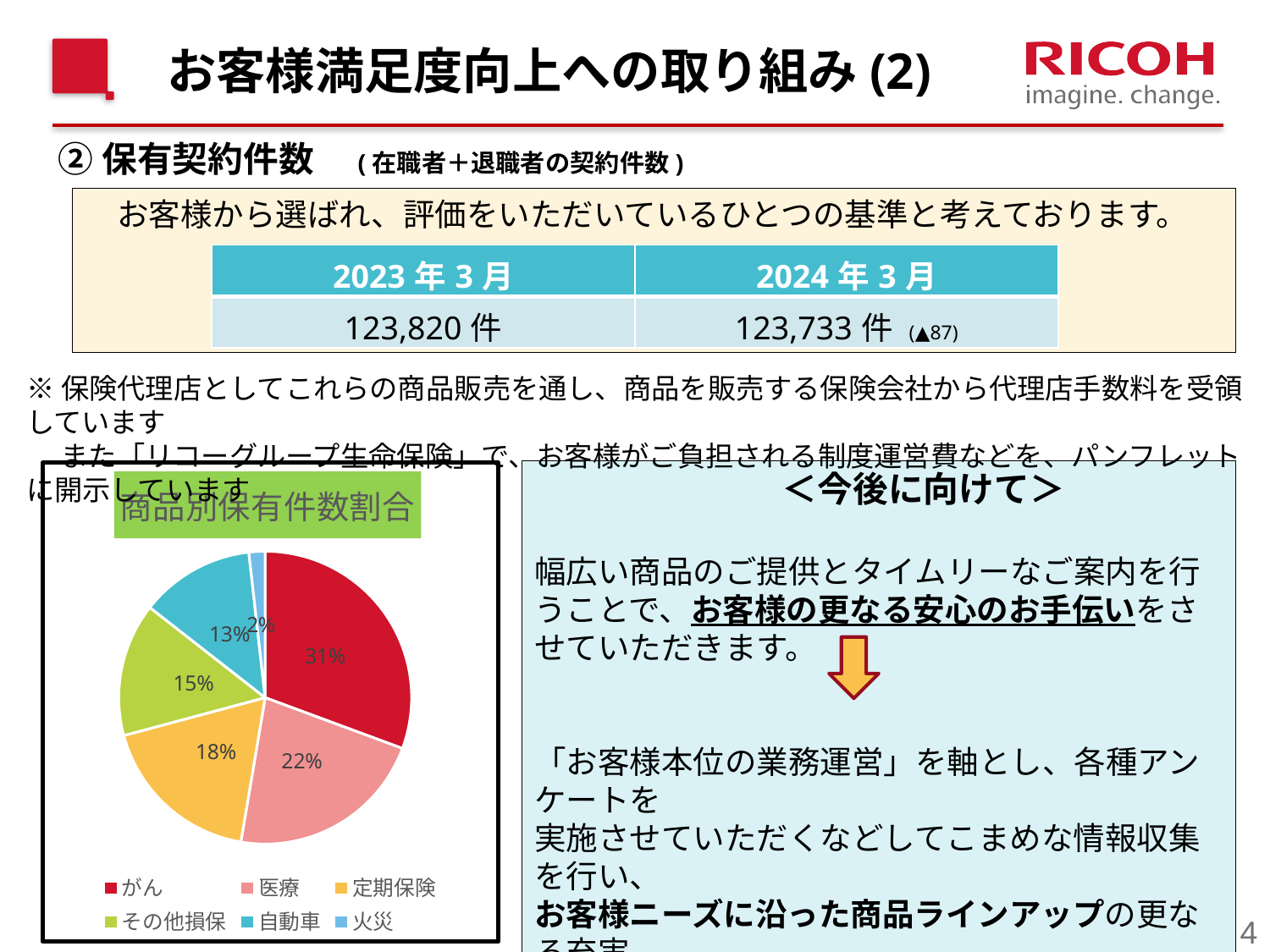
What share of the pie does 自動車 account for? 13% What kind of chart is shown on the slide? pie chart What share of the pie does がん account for? 31% What is the title of the pie chart? 商品別保有件数割合 What share of the pie does 定期保険 account for? 18% Which slice is larger, その他損保 or 自動車? その他損保 What is the difference in percentage points between the がん slice and the 医療 slice? 9 Which category has the largest slice in the pie chart? がん How many entries does the legend of the pie chart list? 6 Which category has the smallest slice in the pie chart? 火災 How many slices does the pie chart have? 6